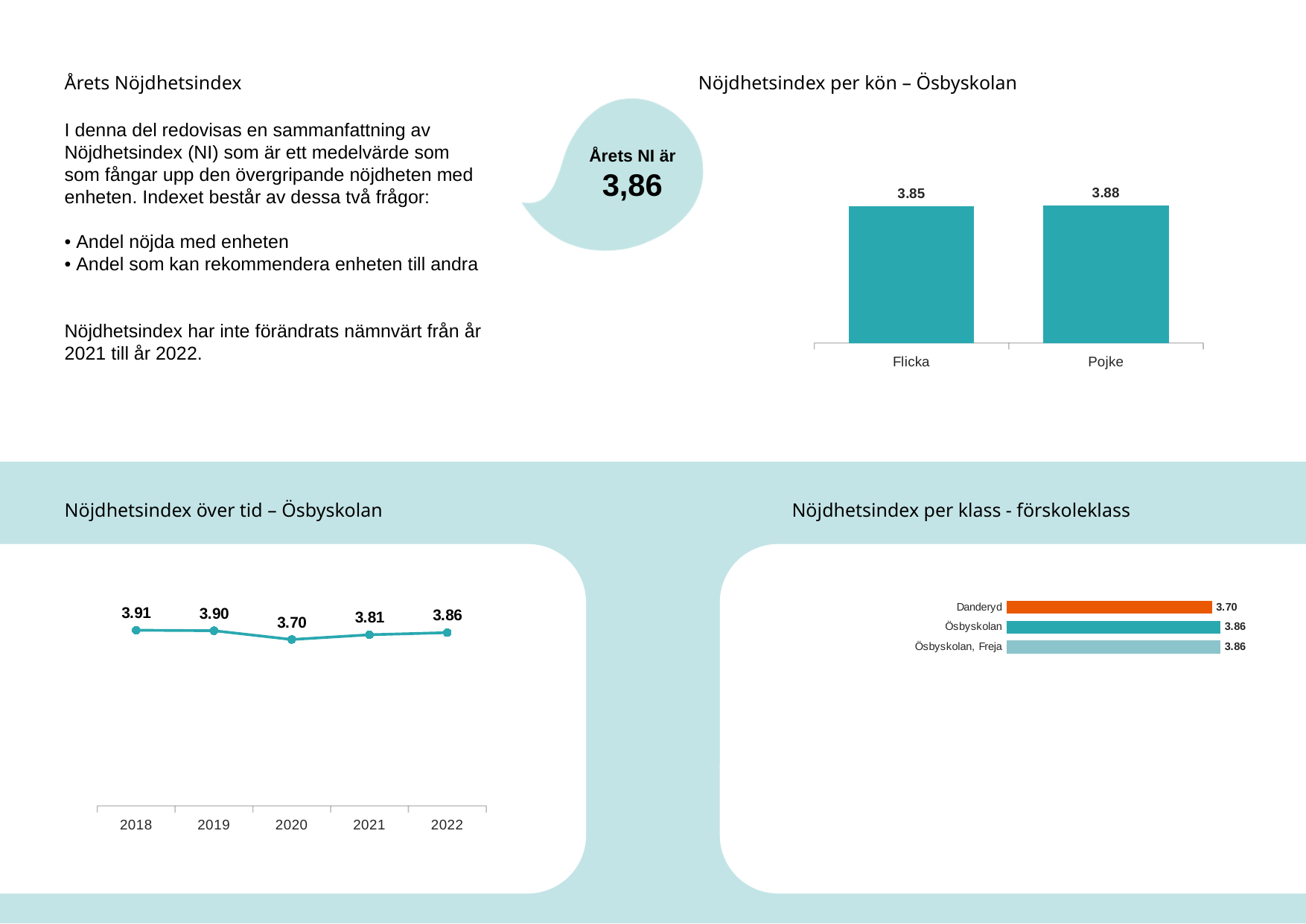
In the chart 'Nöjdhetsindex över tid – Ösbyskolan', which year has the highest value? 2018 In the chart 'Nöjdhetsindex per kön – Ösbyskolan', what is the value for Flicka? 3.85 In the chart 'Nöjdhetsindex per kön – Ösbyskolan', which category has the higher value, Flicka or Pojke? Pojke In the chart 'Nöjdhetsindex per kön – Ösbyskolan', what is the difference between the values for Pojke and Flicka? 0.03 In the chart 'Nöjdhetsindex över tid – Ösbyskolan', how many years are plotted? 5 What kind of chart is 'Nöjdhetsindex per kön – Ösbyskolan'? Bar chart In the chart 'Nöjdhetsindex över tid – Ösbyskolan', what is the value for 2020? 3.70 In the chart 'Nöjdhetsindex per klass - förskoleklass', which category has the lowest value? Danderyd In the chart 'Nöjdhetsindex per klass - förskoleklass', what is the value for Danderyd? 3.70 In the chart 'Nöjdhetsindex över tid – Ösbyskolan', which year has the lowest value? 2020 What kind of chart is 'Nöjdhetsindex över tid – Ösbyskolan'? Line chart In the chart 'Nöjdhetsindex över tid – Ösbyskolan', what is the difference between the values for 2022 and 2021? 0.05